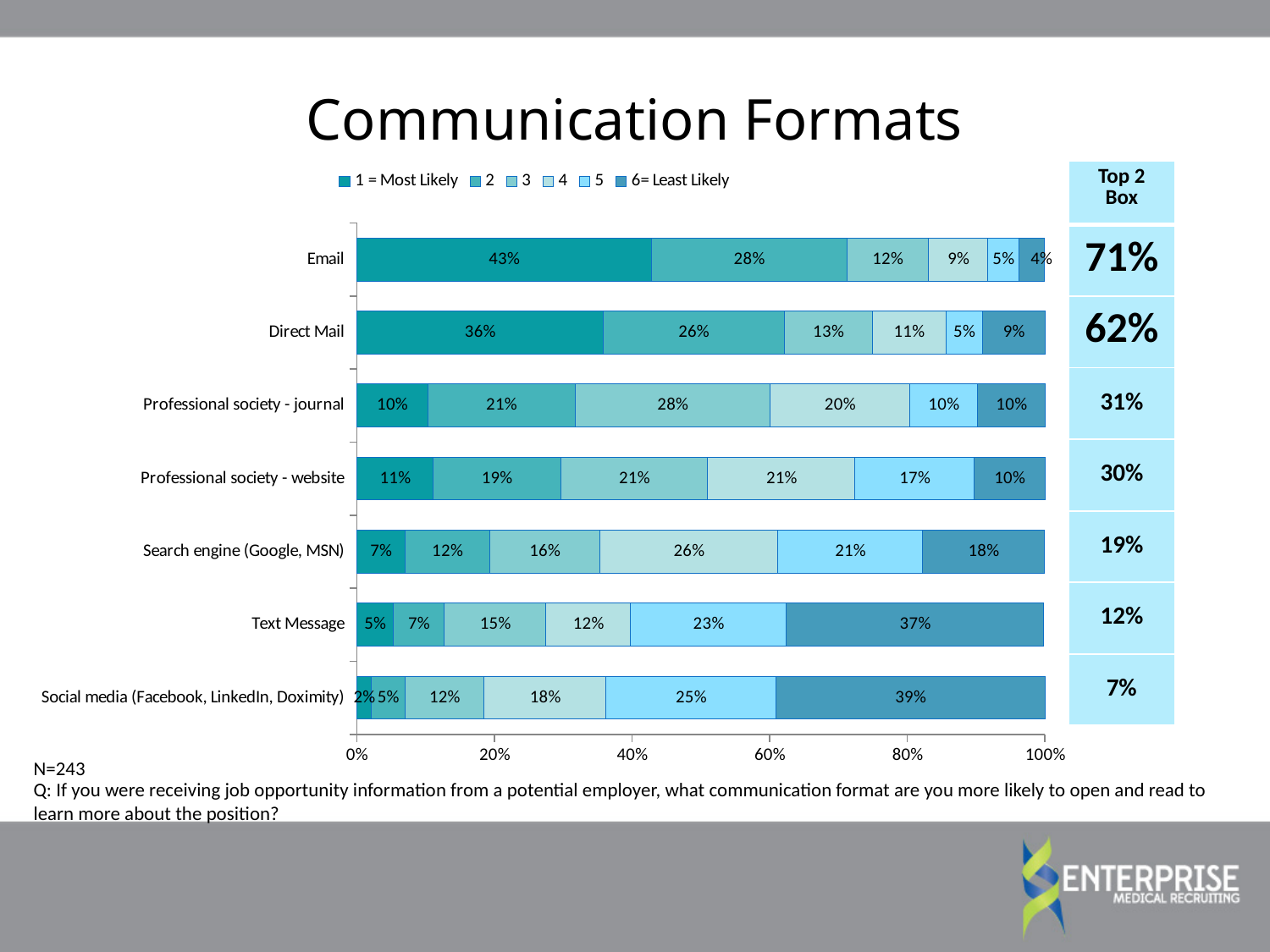
Which communication format has the lowest "1 = Most Likely" percentage? Social media (Facebook, LinkedIn, Doximity) Which communication format has the highest "1 = Most Likely" percentage? Email What is the difference between the "1 = Most Likely" values for Email and Direct Mail? 7% Which has a larger "6= Least Likely" value, Search engine (Google, MSN) or Text Message? Text Message What is the first entry in the chart's legend? 1 = Most Likely What is the Top 2 Box value for Direct Mail? 62% How many series does the legend list? 6 How many communication formats are shown in the chart? 7 What is the "3" rating value for Professional society - journal? 28% What is the "6= Least Likely" value for Text Message? 37% What percentage of respondents rated Email as "1 = Most Likely"? 43% What kind of chart is shown on the slide? Stacked bar chart